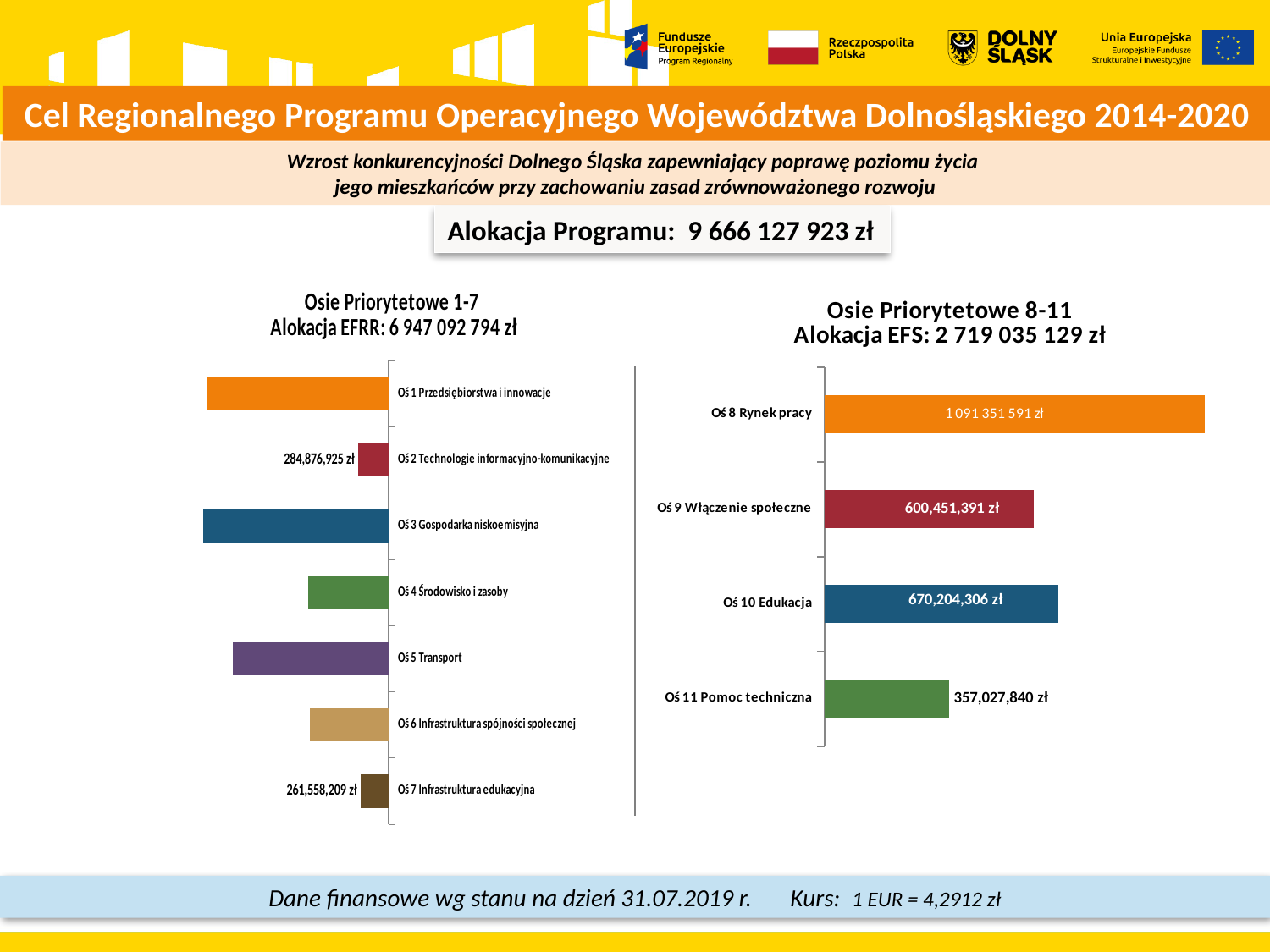
In the chart 'Osie Priorytetowe 8-11', what is the value for Oś 9 Włączenie społeczne? 600,451,391 zł How many categories are shown in the chart 'Osie Priorytetowe 1-7'? 7 In the chart 'Osie Priorytetowe 1-7', what is the difference between the values for Oś 2 and Oś 7? 23,318,716 zł In the chart 'Osie Priorytetowe 1-7', which category has the lowest value? Oś 7 Infrastruktura edukacyjna In the chart 'Osie Priorytetowe 8-11', which category has the lowest value? Oś 11 Pomoc techniczna In the chart 'Osie Priorytetowe 8-11', what is the value for Oś 8 Rynek pracy? 1 091 351 591 zł In the chart 'Osie Priorytetowe 8-11', what is the difference between the values for Oś 10 Edukacja and Oś 9 Włączenie społeczne? 69,752,915 zł In the chart 'Osie Priorytetowe 8-11', which category has the highest value? Oś 8 Rynek pracy What kind of chart is the chart 'Osie Priorytetowe 8-11'? Bar chart In the chart 'Osie Priorytetowe 1-7', what is the value for Oś 2 Technologie informacyjno-komunikacyjne? 284,876,925 zł In the chart 'Osie Priorytetowe 8-11', which is larger: Oś 9 Włączenie społeczne or Oś 10 Edukacja? Oś 10 Edukacja In the chart 'Osie Priorytetowe 8-11', what is the value for Oś 11 Pomoc techniczna? 357,027,840 zł